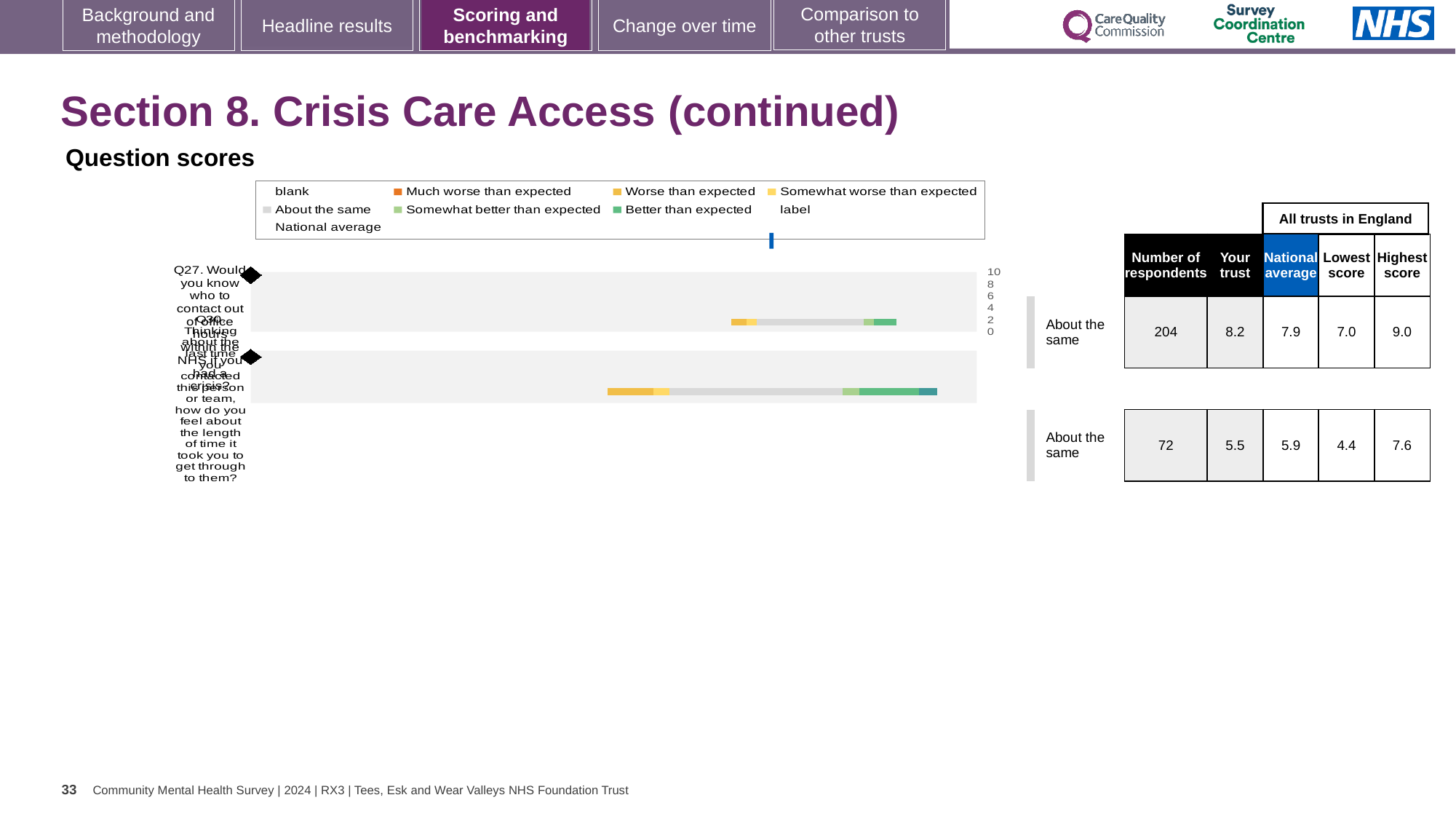
What is the lowest score among all trusts in England for Q30? 4.4 How many respondents answered Q27 according to the table? 204 What is the national average score for Q30 shown in the table? 5.9 What is the highest score among all trusts in England for Q27? 9.0 What kind of chart is shown under 'Question scores'? bar chart Which question has the higher 'Your trust' score, Q27 or Q30? Q27 How many questions (bars) are plotted in the Question scores chart? 2 What is the national average score for Q27 shown in the table? 7.9 What is the difference between the 'Your trust' score and the national average for Q27? 0.3 In the table beside the chart, what is the 'Your trust' score for Q30? 5.5 In the table beside the chart, what is the 'Your trust' score for Q27? 8.2 How many respondents answered Q30 according to the table? 72